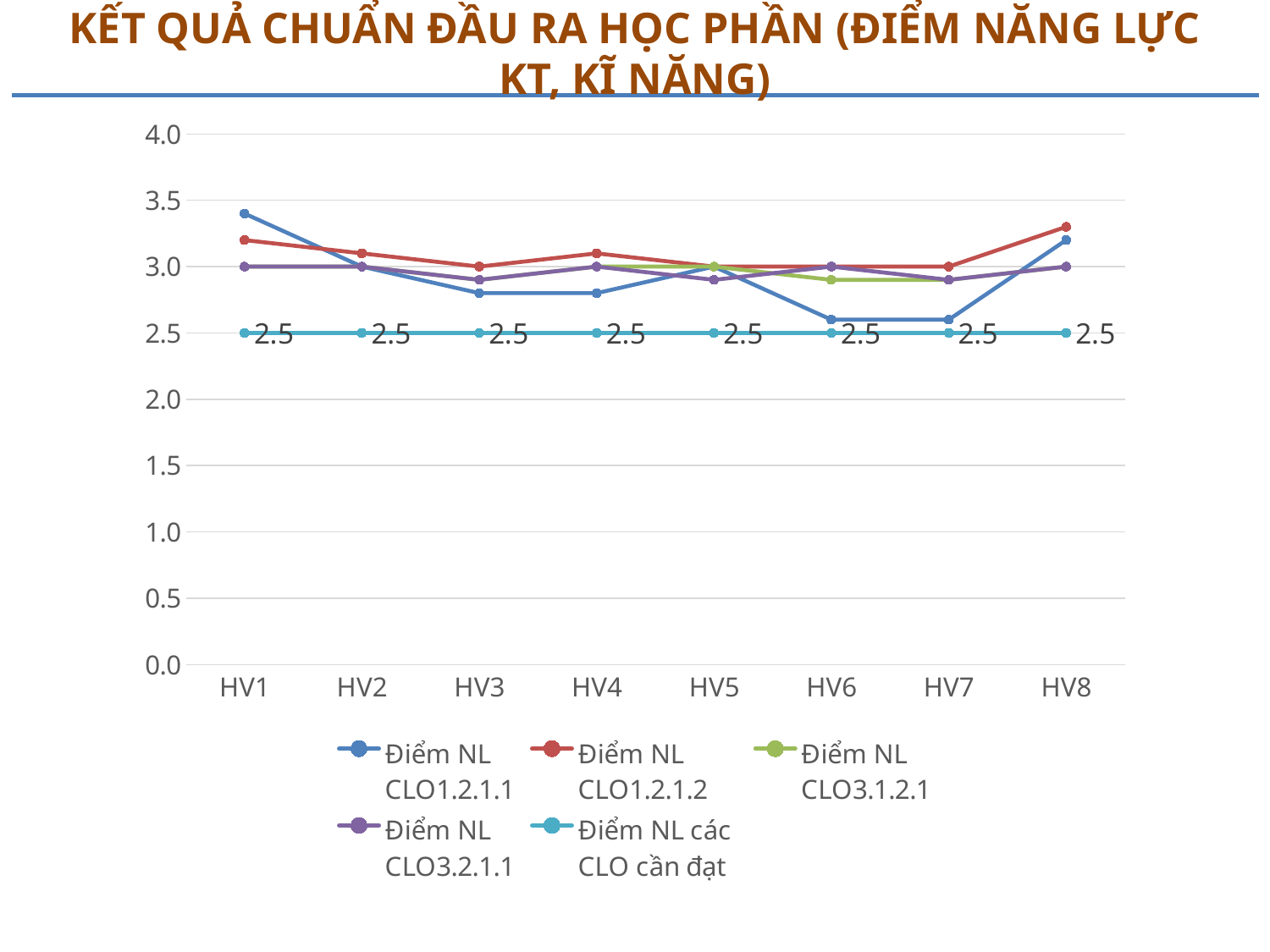
What kind of chart is shown on the slide? Line chart How many categories are shown on the x axis? 8 Does the "Điểm NL các CLO cần đạt" series rise, fall, or stay the same from HV1 to HV8? Stays the same Is the value for "Điểm NL CLO1.2.1.1" at HV1 greater or less than 3.0? greater For the "Điểm NL CLO1.2.1.1" series, which category has the highest value? HV1 What is the value of the "Điểm NL các CLO cần đạt" series at HV8? 2.5 At HV1, which is larger: "Điểm NL CLO1.2.1.1" or "Điểm NL CLO1.2.1.2"? Điểm NL CLO1.2.1.1 What is the value of the "Điểm NL các CLO cần đạt" series at HV3? 2.5 Is the value for "Điểm NL CLO1.2.1.1" at HV6 greater or less than 3.0? less How many series does the legend list? 5 Is the value for "Điểm NL CLO1.2.1.2" at HV8 greater or less than 3.0? greater At HV6, which is larger: "Điểm NL CLO1.2.1.1" or "Điểm NL CLO1.2.1.2"? Điểm NL CLO1.2.1.2